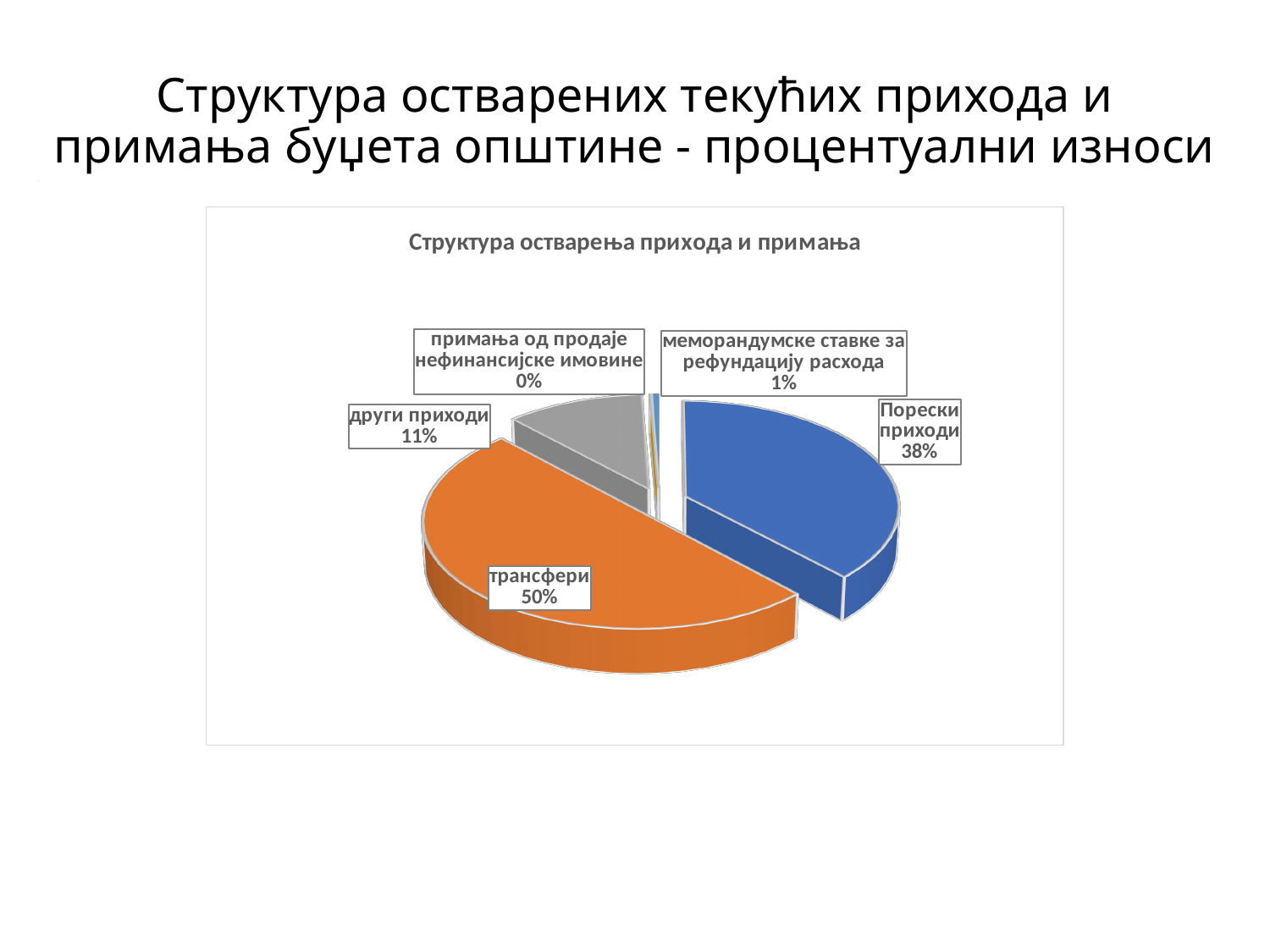
What is the share for трансфери? 50% Which is larger, the share for други приходи or the share for Порески приходи? Порески приходи Which category has the largest share of the pie? трансфери What kind of chart is shown on the slide? pie chart What is the share for примања од продаје нефинансијске имовине? 0% How many categories are shown in the pie chart? 5 What is the difference in percentage points between трансфери and Порески приходи? 12 Which category has the smallest share of the pie? примања од продаје нефинансијске имовине What is the share for Порески приходи? 38% What is the share for други приходи? 11% What is the share for меморандумске ставке за рефундацију расхода? 1% What is the title of the chart? Структура остварења прихода и примања